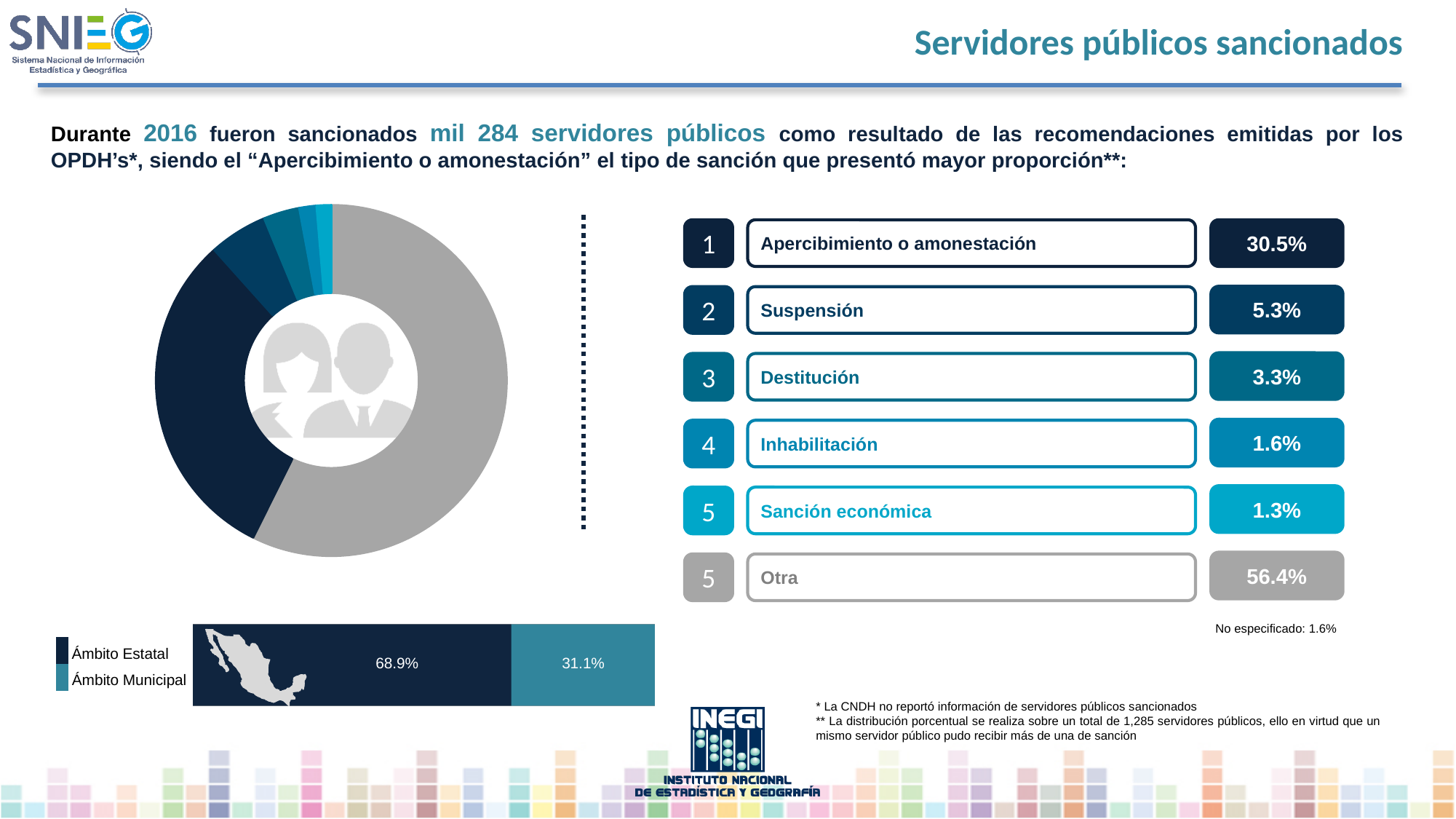
In the donut chart of sanction types, which category has the largest share? Otra In the donut chart of sanction types, what share corresponds to "Suspensión"? 5.3% In the bar chart at the bottom of the slide, what is the value for "Ámbito Estatal"? 68.9% In the donut chart of sanction types, what share corresponds to "Apercibimiento o amonestación"? 30.5% In the donut chart of sanction types, which is larger: "Destitución" or "Inhabilitación"? Destitución How many sanction categories are listed next to the donut chart? 6 In the donut chart of sanction types, what share corresponds to "Destitución"? 3.3% In the donut chart of sanction types, which category has the smallest share? Sanción económica In the donut chart of sanction types, what share corresponds to "Sanción económica"? 1.3% In the donut chart of sanction types, what is the difference between the shares of "Apercibimiento o amonestación" and "Suspensión"? 25.2% How many series does the legend of the bar chart at the bottom of the slide list? 2 In the bar chart at the bottom of the slide, what is the value for "Ámbito Municipal"? 31.1%